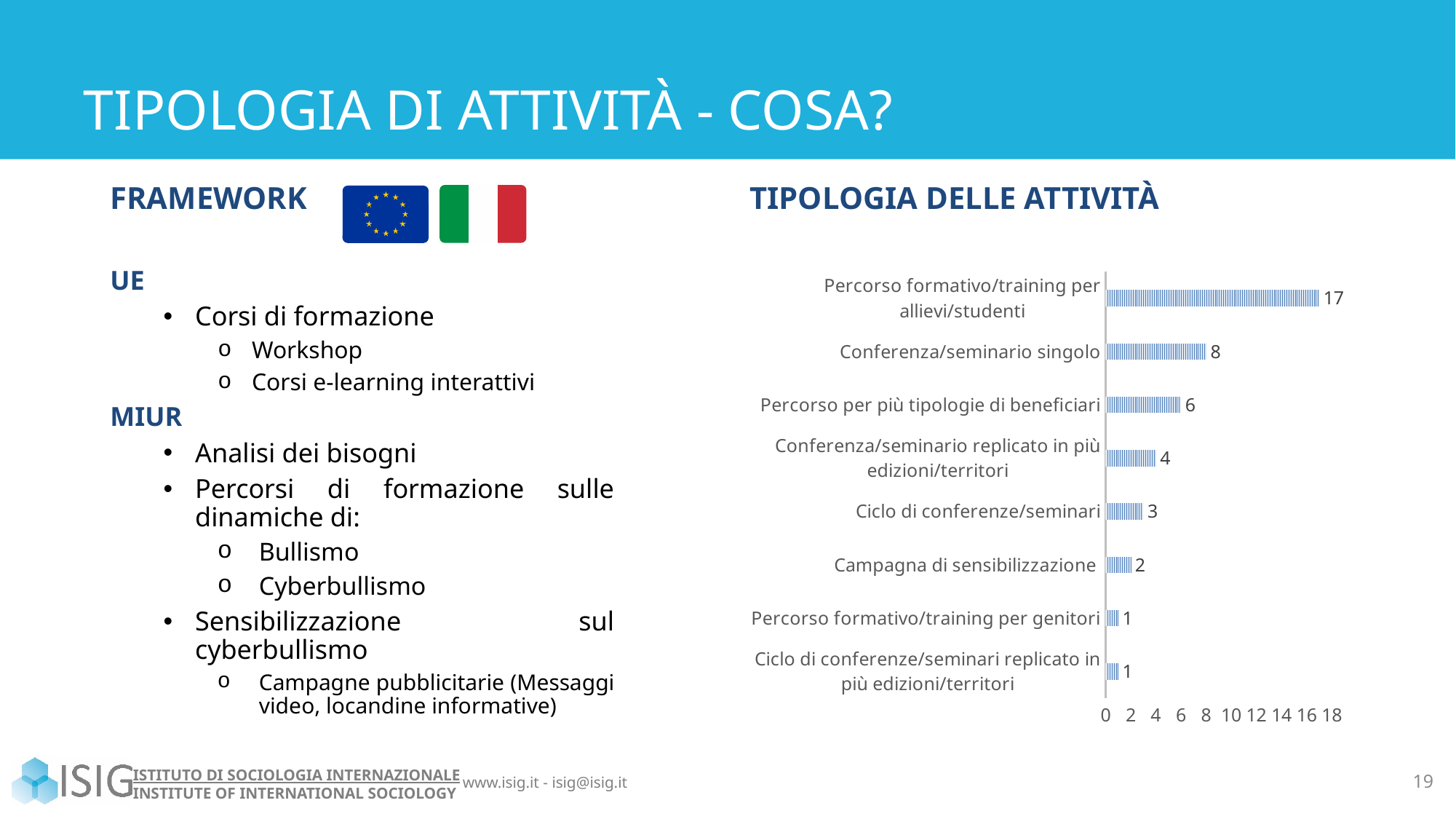
What is the title of the chart? TIPOLOGIA DELLE ATTIVITÀ What is the value for Conferenza/seminario singolo? 8 What kind of chart is shown on the slide? bar chart Which category has the highest value? Percorso formativo/training per allievi/studenti Is the value for Percorso formativo/training per allievi/studenti greater or less than 16? greater What is the value for Percorso per più tipologie di beneficiari? 6 Which is larger: Ciclo di conferenze/seminari or Conferenza/seminario replicato in più edizioni/territori? Conferenza/seminario replicato in più edizioni/territori What is the value for Percorso formativo/training per allievi/studenti? 17 What is the difference between Percorso formativo/training per allievi/studenti and Conferenza/seminario singolo? 9 What is the value for Percorso formativo/training per genitori? 1 What is the value for Campagna di sensibilizzazione? 2 How many categories are shown in the chart? 8